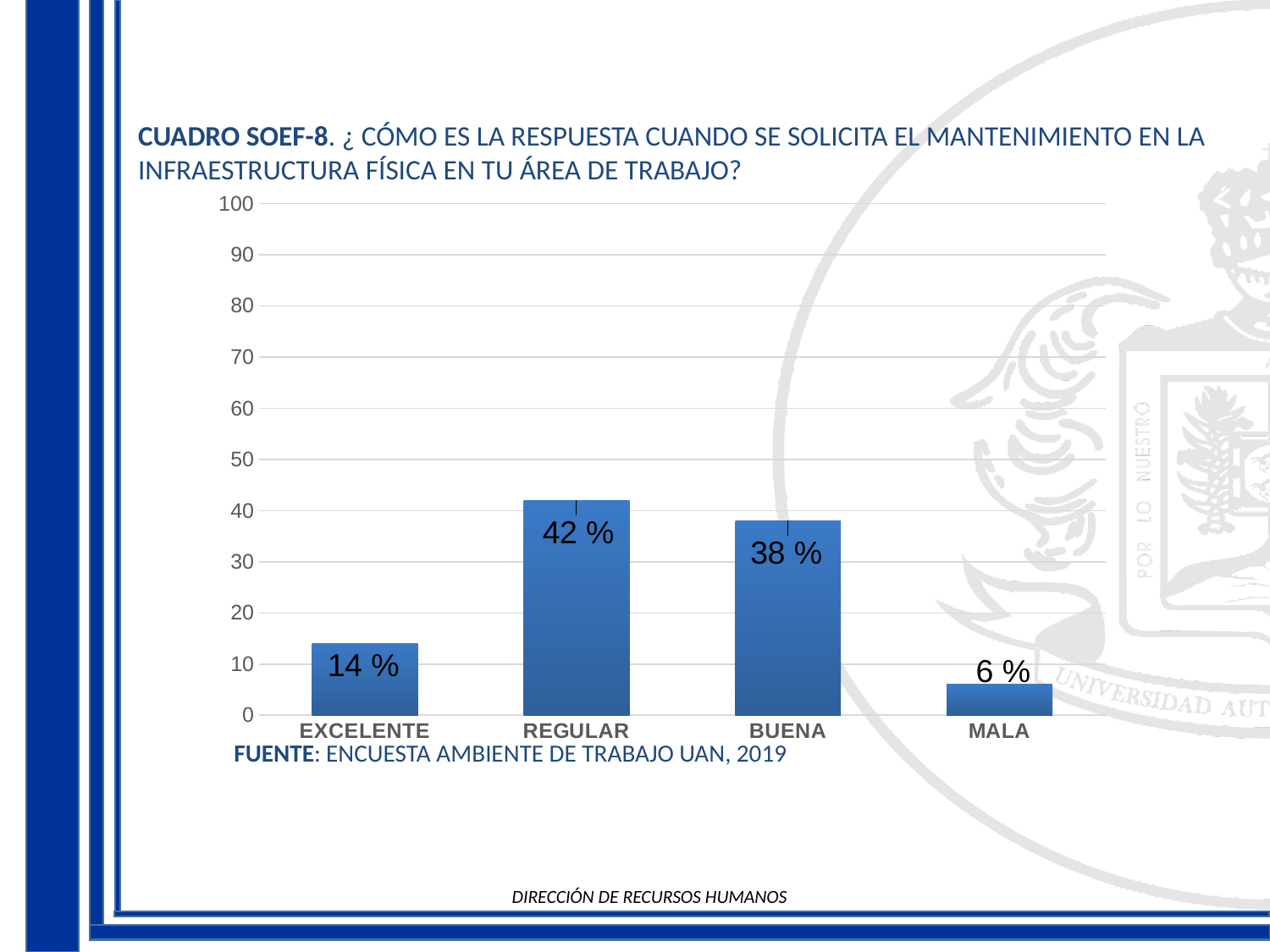
What kind of chart is shown on the slide? bar chart What source is cited below the chart? ENCUESTA AMBIENTE DE TRABAJO UAN, 2019 How many categories are shown on the x axis? 4 Which category has the lowest value? MALA Which is larger, the value for EXCELENTE or the value for MALA? EXCELENTE Is the value for BUENA greater or less than 30? greater Which category has the highest value? REGULAR What is the value for BUENA? 38 % What is the value for MALA? 6 % What is the difference between the values for REGULAR and BUENA? 4 % What is the value for REGULAR? 42 % What is the value for EXCELENTE? 14 %